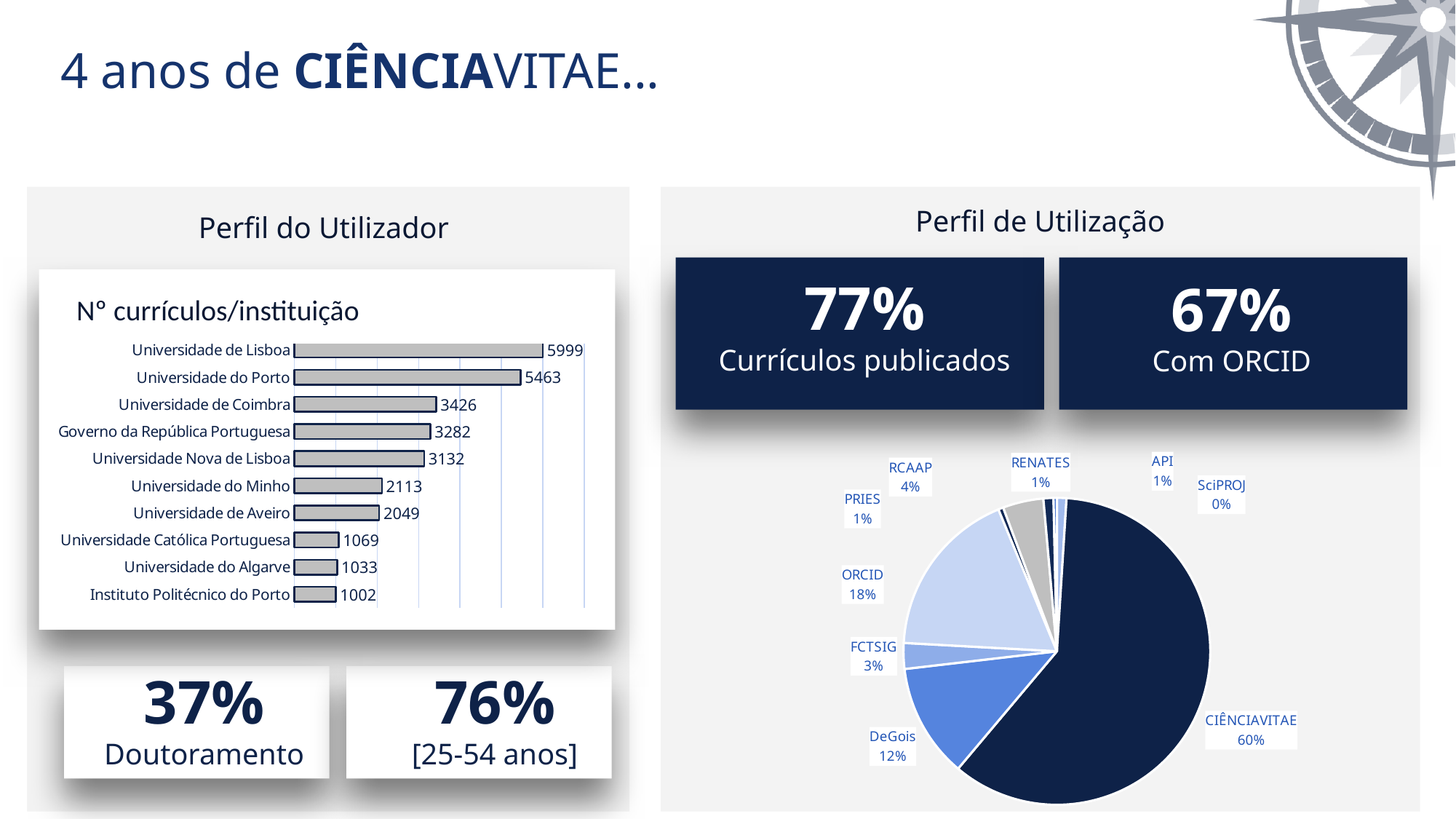
In the 'Nº currículos/instituição' bar chart, what is the difference between Universidade de Lisboa and Universidade do Porto? 536 In the 'Nº currículos/instituição' bar chart, what is the value for Universidade do Minho? 2113 In the pie chart on the right, what share does CIÊNCIAVITAE have? 60% In the 'Nº currículos/instituição' bar chart, which institution has the highest value? Universidade de Lisboa In the pie chart on the right, which slice is the largest? CIÊNCIAVITAE In the 'Nº currículos/instituição' bar chart, which institution has the lowest value? Instituto Politécnico do Porto In the 'Nº currículos/instituição' bar chart, which is larger: Universidade de Coimbra or Universidade Nova de Lisboa? Universidade de Coimbra In the pie chart on the right, what share does ORCID have? 18% How many institutions are shown in the 'Nº currículos/instituição' bar chart? 10 How many slices are labelled in the pie chart on the right? 9 What kind of chart is 'Nº currículos/instituição'? Bar chart In the 'Nº currículos/instituição' bar chart, what is the value for Universidade do Porto? 5463